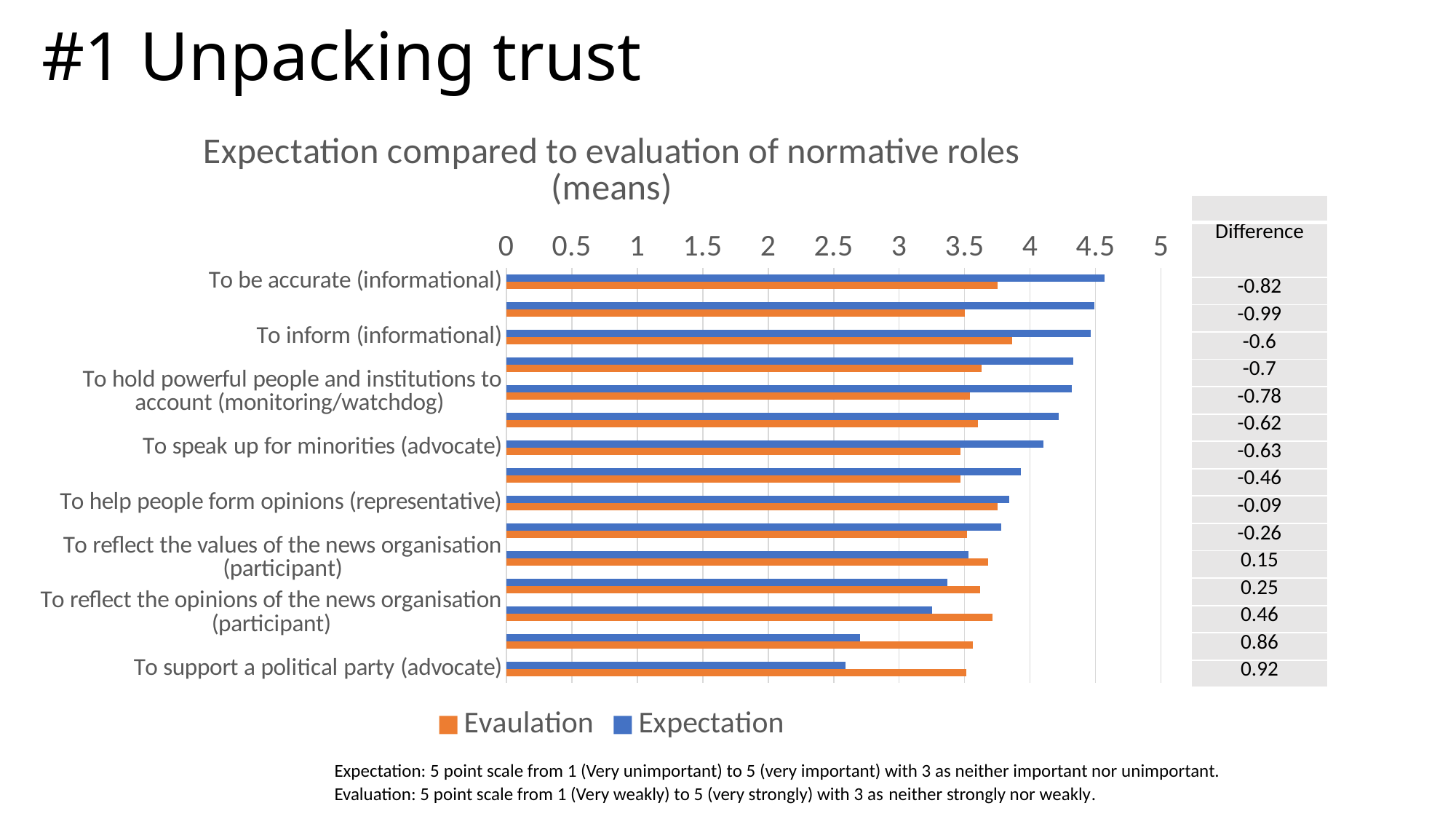
Is the Expectation value for 'To reflect the opinions of the news organisation (participant)' greater or less than 3.5? less What kind of chart is shown on the slide? bar chart Is the Expectation value for 'To be accurate (informational)' greater or less than 4? greater How many category labels are shown on the vertical axis of the chart? 8 For 'To be accurate (informational)', which is larger: the Expectation value or the Evaulation value? Expectation Is the Evaulation value for 'To support a political party (advocate)' greater or less than 3? greater Going down the chart from 'To be accurate (informational)' to 'To support a political party (advocate)', do the Expectation values generally rise or fall? fall For 'To support a political party (advocate)', which is larger: the Expectation value or the Evaulation value? Evaulation How many series does the legend list? 2 What is the title of the chart? Expectation compared to evaluation of normative roles (means) What are the two series named in the legend? Evaulation and Expectation